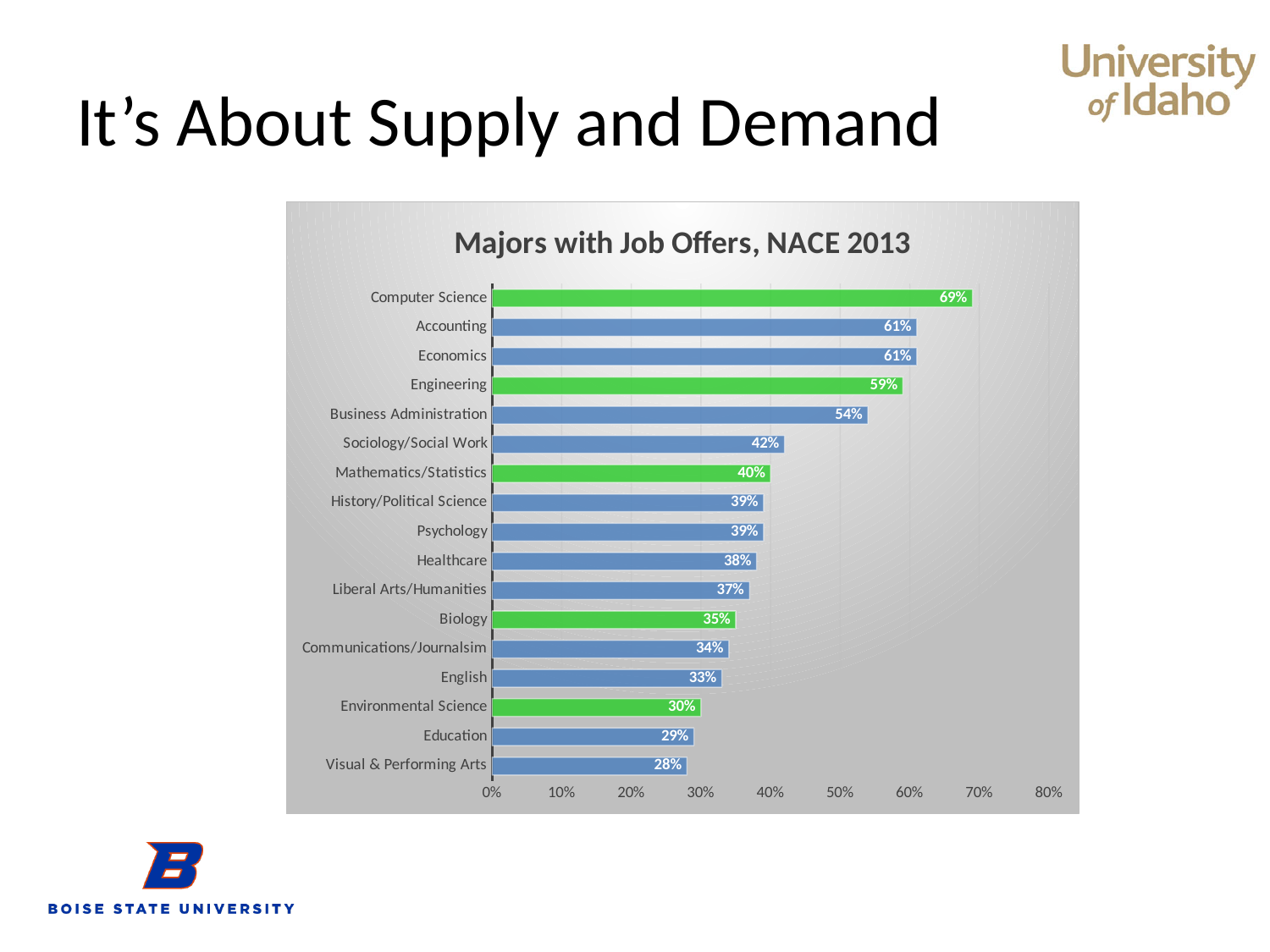
Which is larger, the value for Biology or the value for Healthcare? Healthcare What is the title of the chart? Majors with Job Offers, NACE 2013 Which major has the highest percentage with job offers? Computer Science What kind of chart is shown on the slide? Bar chart How many majors are shown in the chart? 17 What is the difference between the values for Sociology/Social Work and Education? 13% What is the difference between the values for Computer Science and Engineering? 10% What is the value for Business Administration? 54% Which major has the lowest percentage with job offers? Visual & Performing Arts What is the value for Computer Science? 69% What is the value for Environmental Science? 30% Is the value for Mathematics/Statistics greater or less than 50%? less